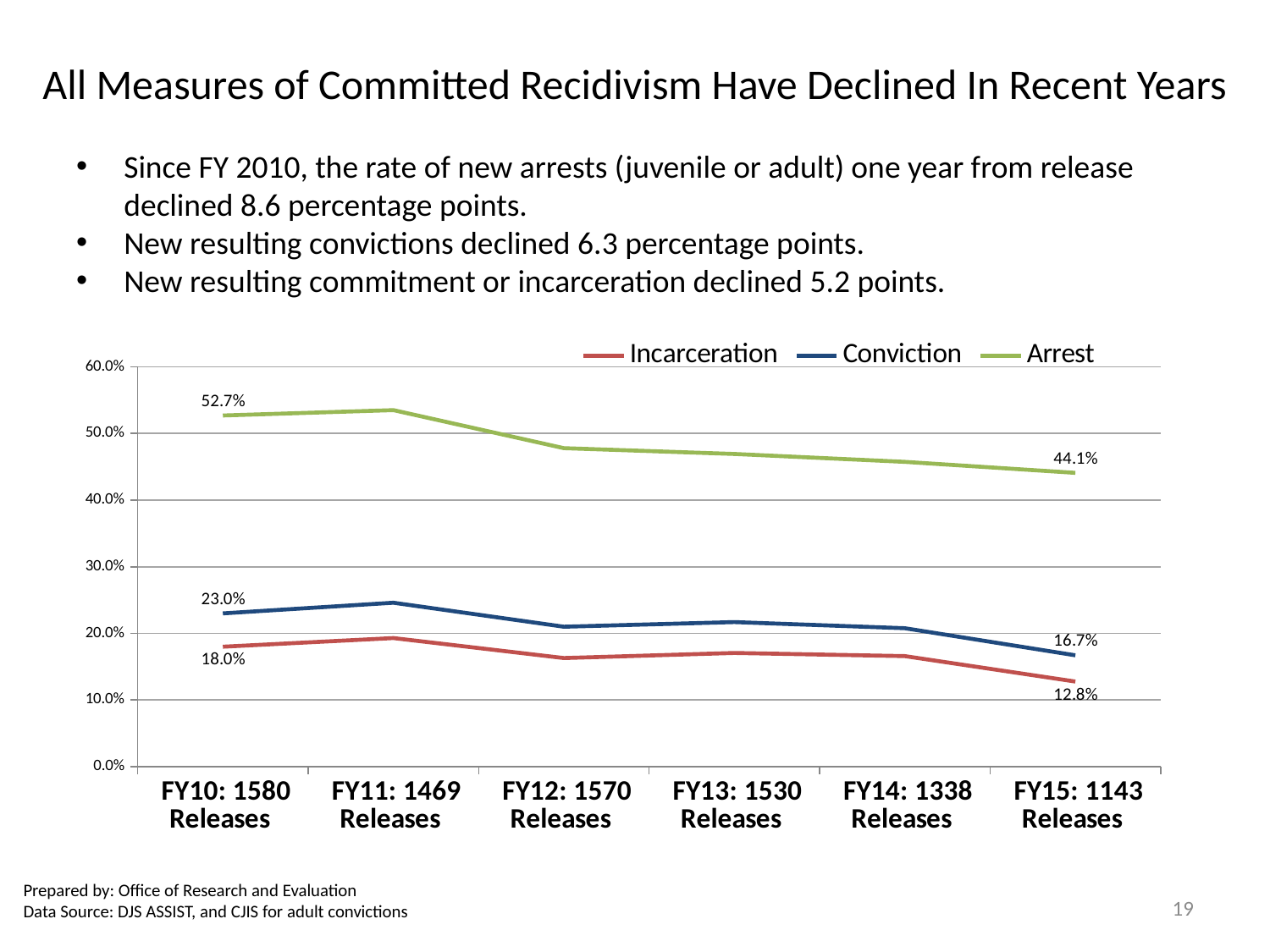
Is the Arrest rate for FY12: 1570 Releases greater or less than 50.0%? less Which series has the highest value at FY10: 1580 Releases? Arrest How many fiscal year categories are shown on the x axis? 6 Is the Conviction rate for FY11: 1469 Releases greater or less than 20.0%? greater Which series has the lowest value at FY15: 1143 Releases? Incarceration What is the difference between the Conviction rate and the Incarceration rate at FY10: 1580 Releases? 5.0 percentage points What kind of chart is shown on the slide? Line chart How many series does the legend list? 3 What is the Conviction rate for FY15: 1143 Releases? 16.7% By how many percentage points did the Arrest rate fall from FY10 to FY15? 8.6 What is the Incarceration rate for FY15: 1143 Releases? 12.8% What is the Arrest rate for FY10: 1580 Releases? 52.7%